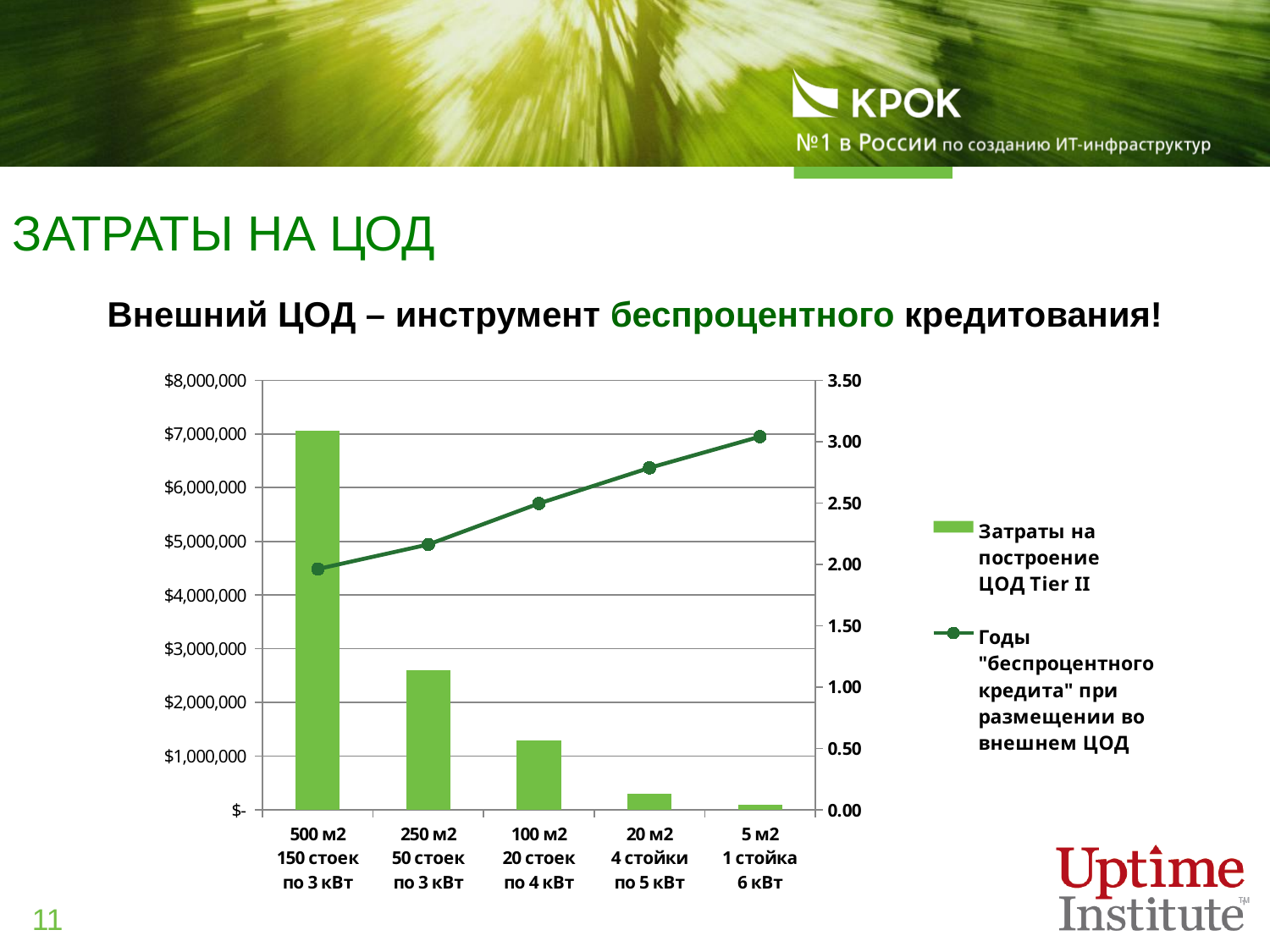
Do the bars for 'Затраты на построение ЦОД Tier II' rise or fall from left to right along the x axis? fall Is the bar value for '500 м2 150 стоек по 3 кВт' greater or less than $6,000,000? greater Is the bar value for '100 м2 20 стоек по 4 кВт' greater or less than $1,000,000? greater Which category has the highest bar for 'Затраты на построение ЦОД Tier II'? 500 м2 150 стоек по 3 кВт Is the bar value for '250 м2 50 стоек по 3 кВт' greater or less than $3,000,000? less Which bar is taller: '250 м2 50 стоек по 3 кВт' or '100 м2 20 стоек по 4 кВт'? 250 м2 50 стоек по 3 кВт How many series does the chart legend list? 2 Which category has the lowest bar for 'Затраты на построение ЦОД Tier II'? 5 м2 1 стойка 6 кВт How many categories are shown on the x axis of the chart? 5 What kind of chart is shown on the slide? A combined bar and line chart Does the line for 'Годы "беспроцентного кредита"' rise or fall from left to right along the x axis? rise